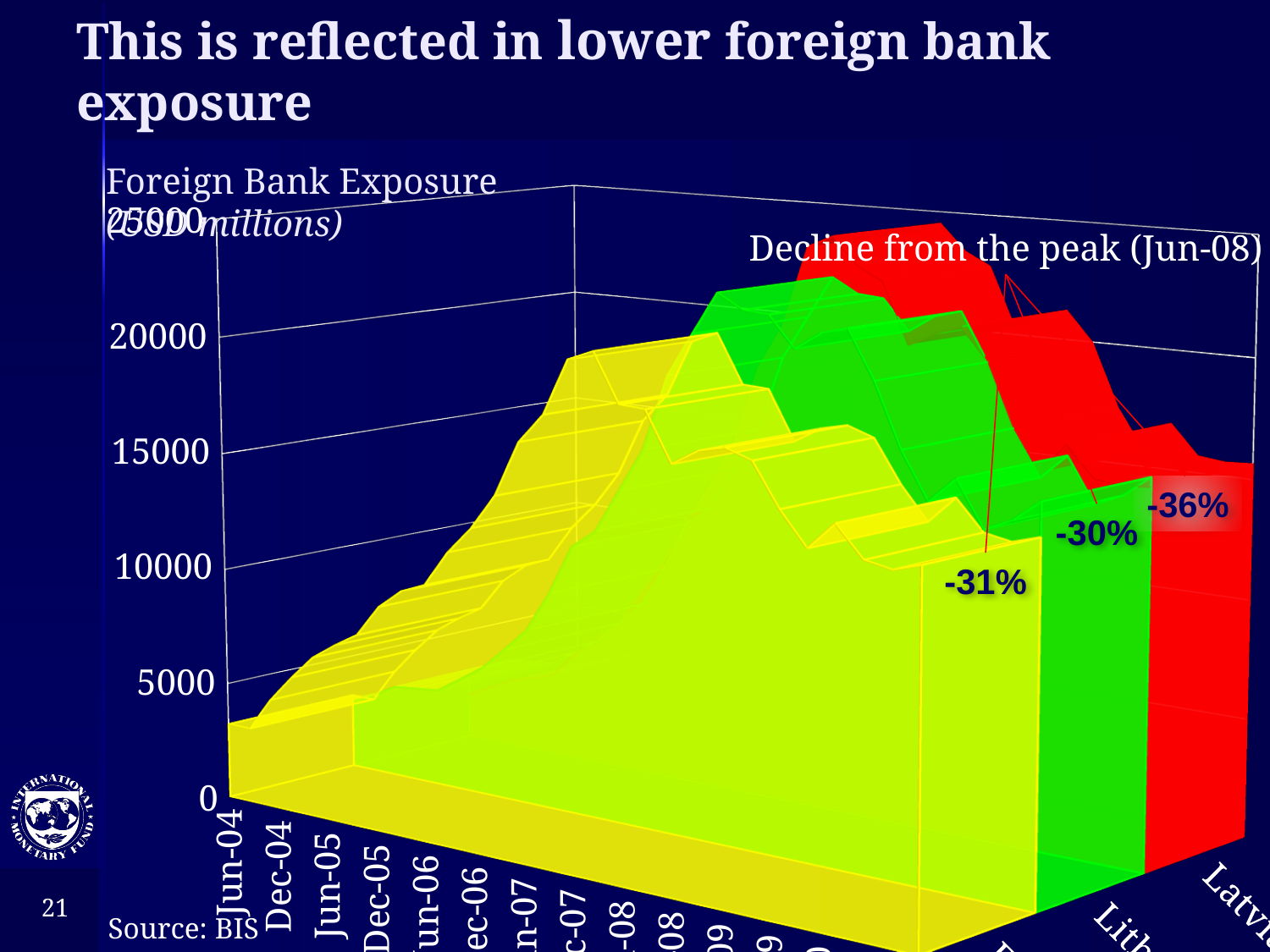
What is the highest value shown on the vertical axis? 25000 How many percentage points larger is the -36% decline than the -30% decline? 6 percentage points What is the decline from the peak shown for the red (Latvia) series? -36% What kind of chart is shown on the slide? Area chart What is the decline from the peak shown for the green (Lithuania) series? -30% What is the source cited for the chart? BIS What is the title of the chart? Foreign Bank Exposure (USD millions) What is the decline from the peak shown for the yellow series? -31% Which series shows the largest percentage decline from the peak? The red (Latvia) series, -36% According to the annotation, in which month did foreign bank exposure peak? Jun-08 Is the value of the yellow series at Jun-04 greater or less than 5000? less Which series shows the smallest percentage decline from the peak? The green (Lithuania) series, -30%